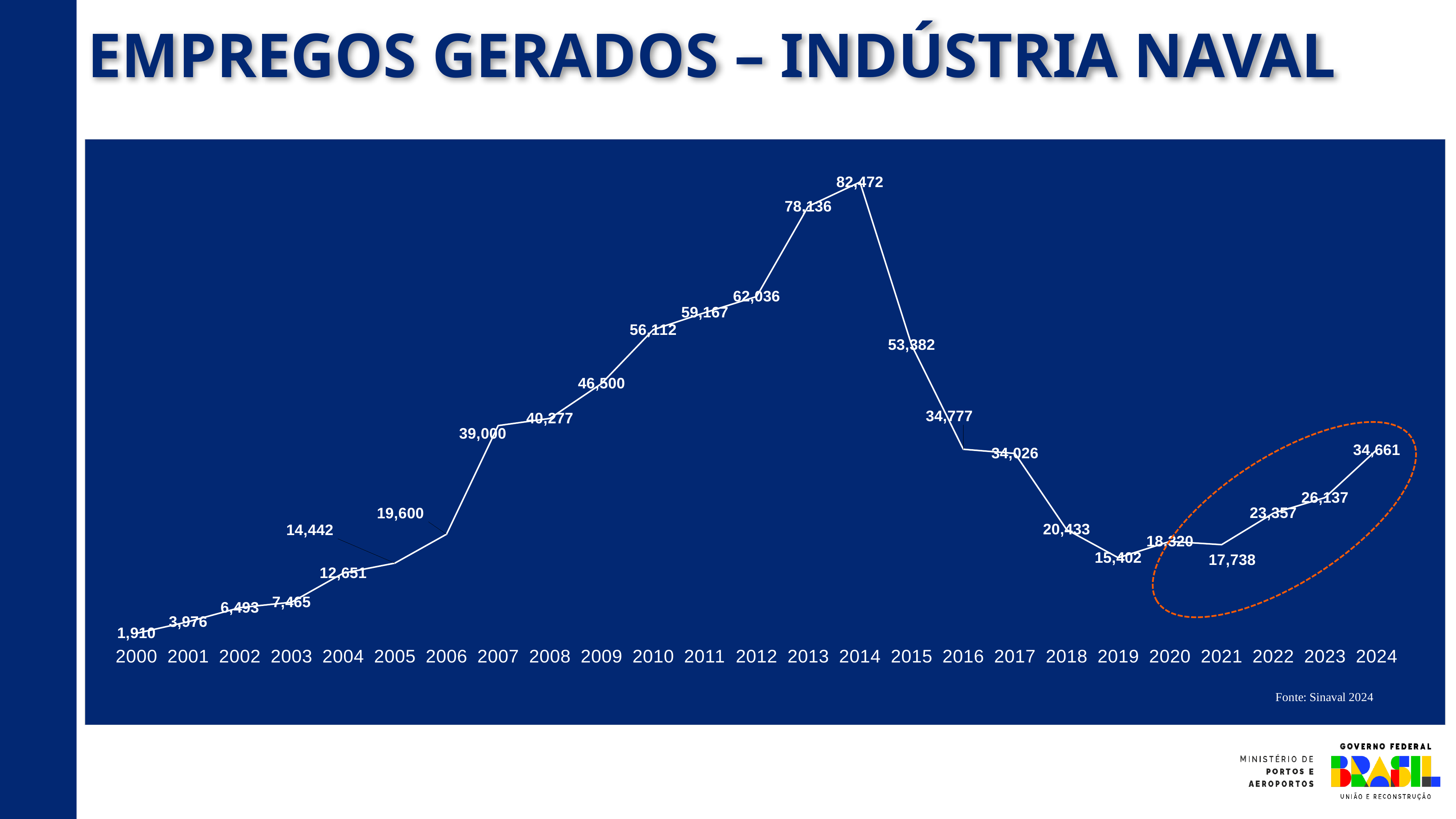
What kind of chart is shown on the slide? Line chart What source is cited for the chart? Sinaval 2024 Which is larger, the value for 2007 or the value for 2006? 2007 What value is shown for 2007? 39,000 What is the difference between the values for 2024 and 2023? 8,524 Do the values rise or fall from 2014 to 2019? Fall Which year has the highest value? 2014 What value is shown for 2014? 82,472 How many years are plotted on the chart? 25 Which year has the lowest value? 2000 What is the difference between the values for 2014 and 2013? 4,336 What value is shown for 2024? 34,661